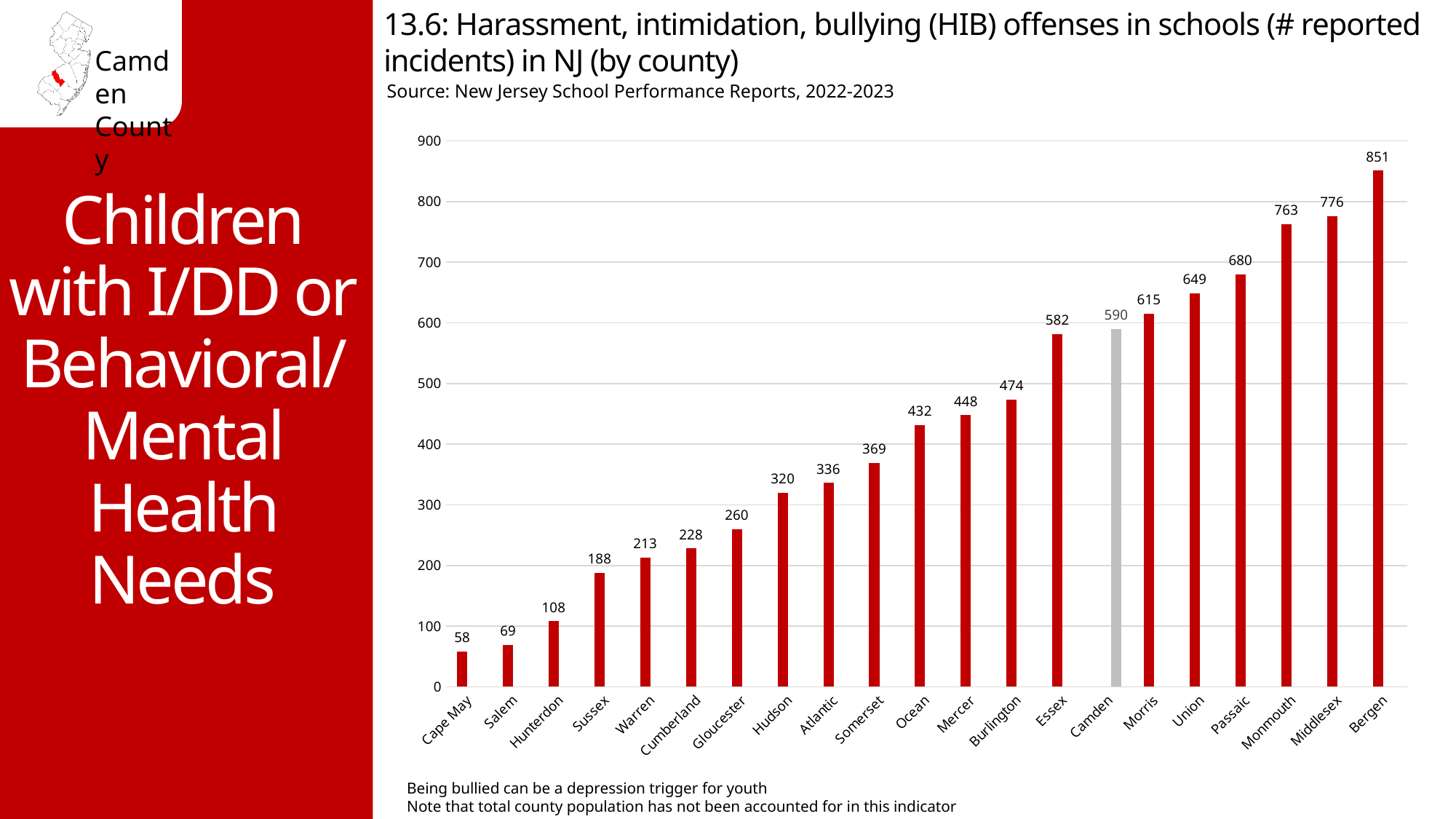
What is the number of reported HIB incidents for Gloucester County? 260 How many counties are shown on the chart? 21 Is the value for Hudson greater or less than 300? greater Which county's bar is shown in gray instead of red? Camden Which county has more reported HIB incidents, Monmouth or Passaic? Monmouth What is the number of reported HIB incidents for Camden County? 590 What is the number of reported HIB incidents for Bergen County? 851 What is the difference in reported HIB incidents between Bergen and Camden? 261 What kind of chart is used to show HIB incidents by county? Bar chart Which county has the highest number of reported HIB incidents? Bergen Which county has the lowest number of reported HIB incidents? Cape May What is the difference in reported HIB incidents between Essex and Burlington? 108